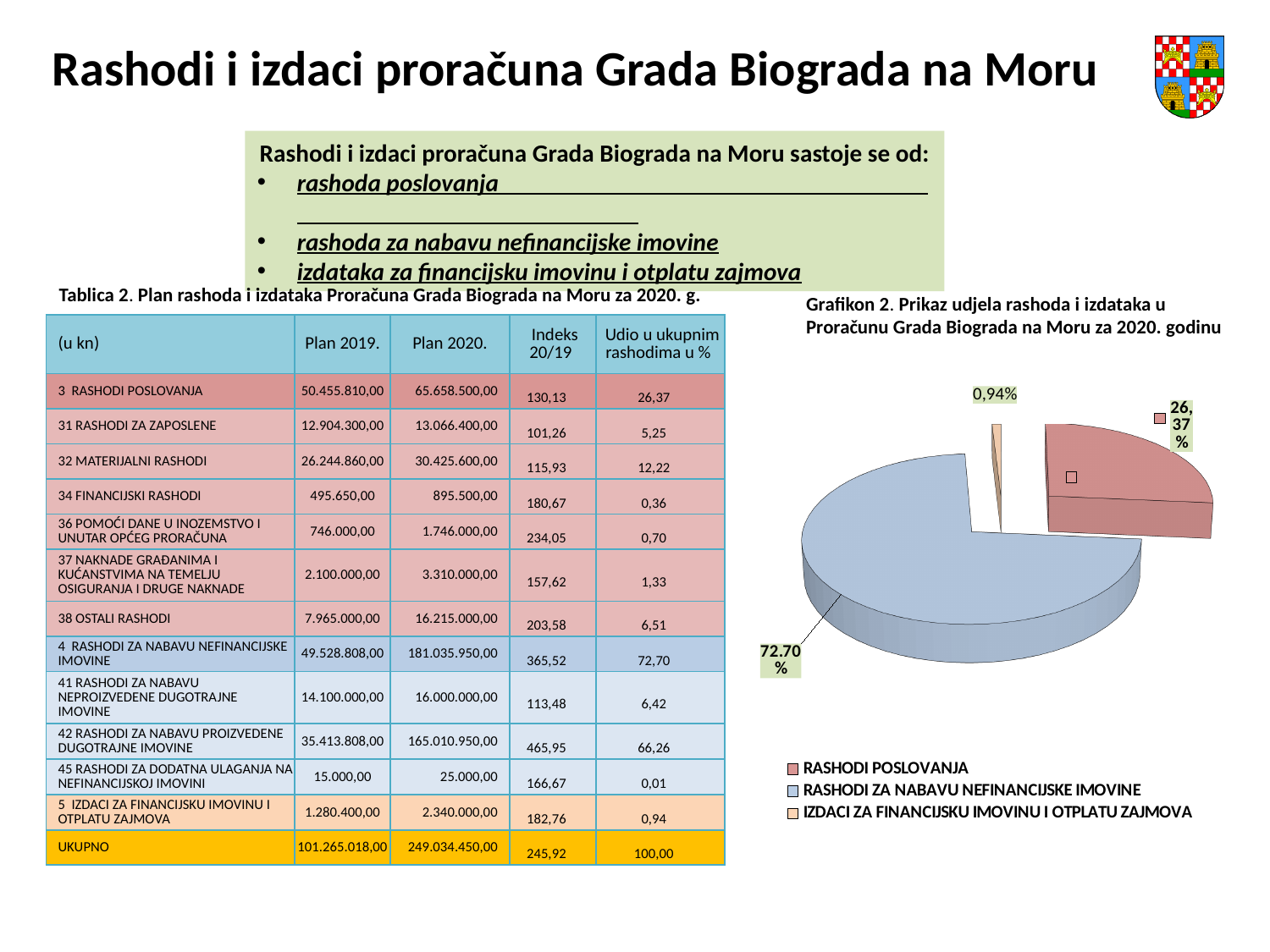
Which is larger: the slice for RASHODI POSLOVANJA or the slice for IZDACI ZA FINANCIJSKU IMOVINU I OTPLATU ZAJMOVA? RASHODI POSLOVANJA Which category has the largest slice of the pie? RASHODI ZA NABAVU NEFINANCIJSKE IMOVINE Which category has the smallest slice of the pie? IZDACI ZA FINANCIJSKU IMOVINU I OTPLATU ZAJMOVA How many slices does the pie chart have? 3 What kind of chart is shown on the slide? pie chart What share of the pie does RASHODI POSLOVANJA have? 26,37% What share of the pie does IZDACI ZA FINANCIJSKU IMOVINU I OTPLATU ZAJMOVA have? 0,94% What share of the pie does RASHODI ZA NABAVU NEFINANCIJSKE IMOVINE have? 72.70% What is the difference in percentage points between the RASHODI POSLOVANJA slice and the IZDACI ZA FINANCIJSKU IMOVINU I OTPLATU ZAJMOVA slice? 25,43 What is the title of the chart? Grafikon 2. Prikaz udjela rashoda i izdataka u Proračunu Grada Biograda na Moru za 2020. godinu How many entries does the chart legend list? 3 Which legend entry is shown in blue? RASHODI ZA NABAVU NEFINANCIJSKE IMOVINE